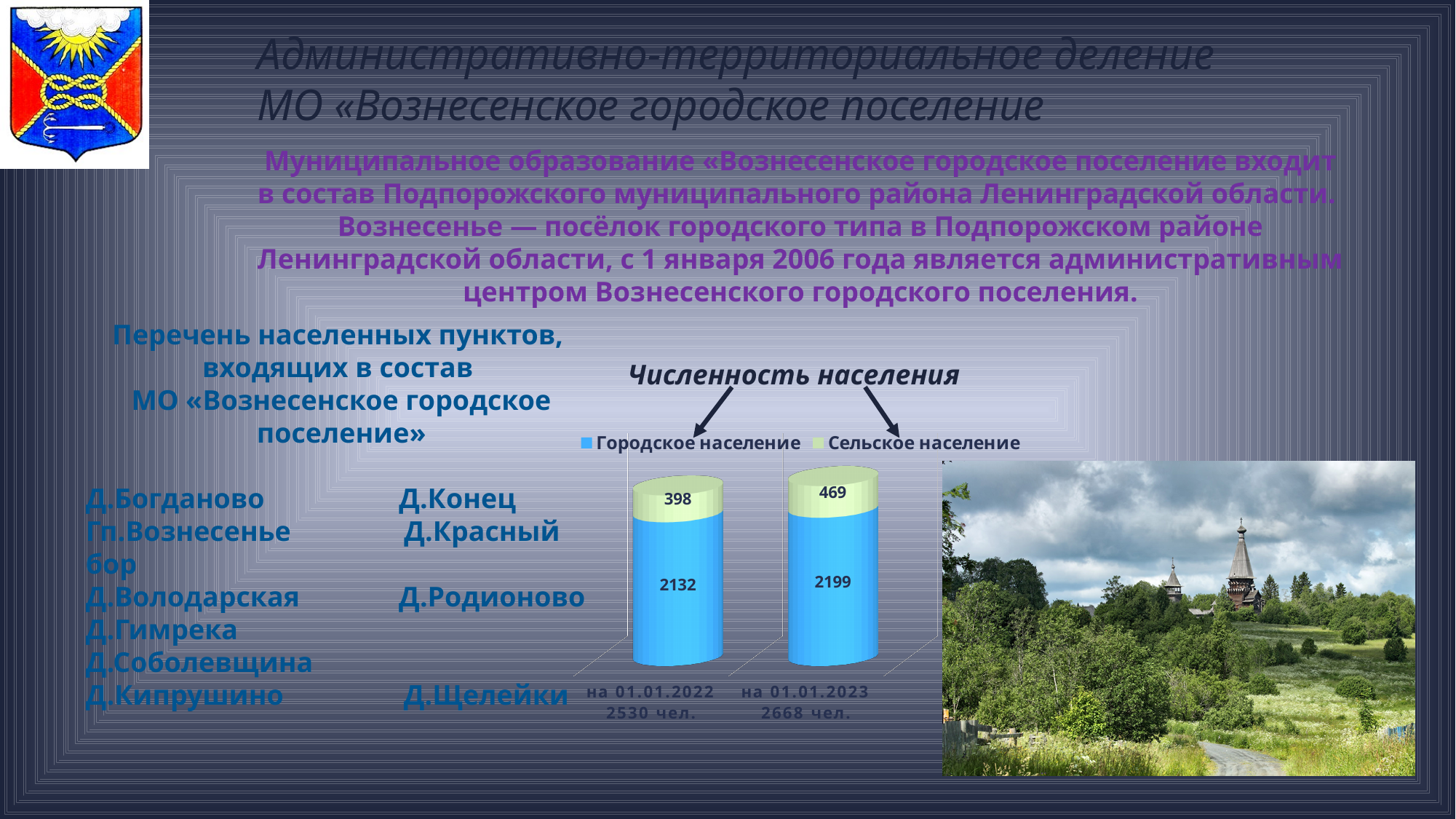
What is the title of the chart? Численность населения What is the value of «Городское население» on 01.01.2022? 2132 Which date has the larger value for «Городское население», 01.01.2022 or 01.01.2023? 01.01.2023 What is the value of «Сельское население» on 01.01.2022? 398 What is the total population shown for the bar on 01.01.2023? 2668 чел. By how much did «Сельское население» change from 01.01.2022 to 01.01.2023? 71 What is the value of «Сельское население» on 01.01.2023? 469 What kind of chart is shown under the title «Численность населения»? bar chart How many series does the chart legend list? 2 What is the value of «Городское население» on 01.01.2023? 2199 How many bars (dates) are shown in the chart? 2 Does the total population rise or fall from 01.01.2022 to 01.01.2023? rise